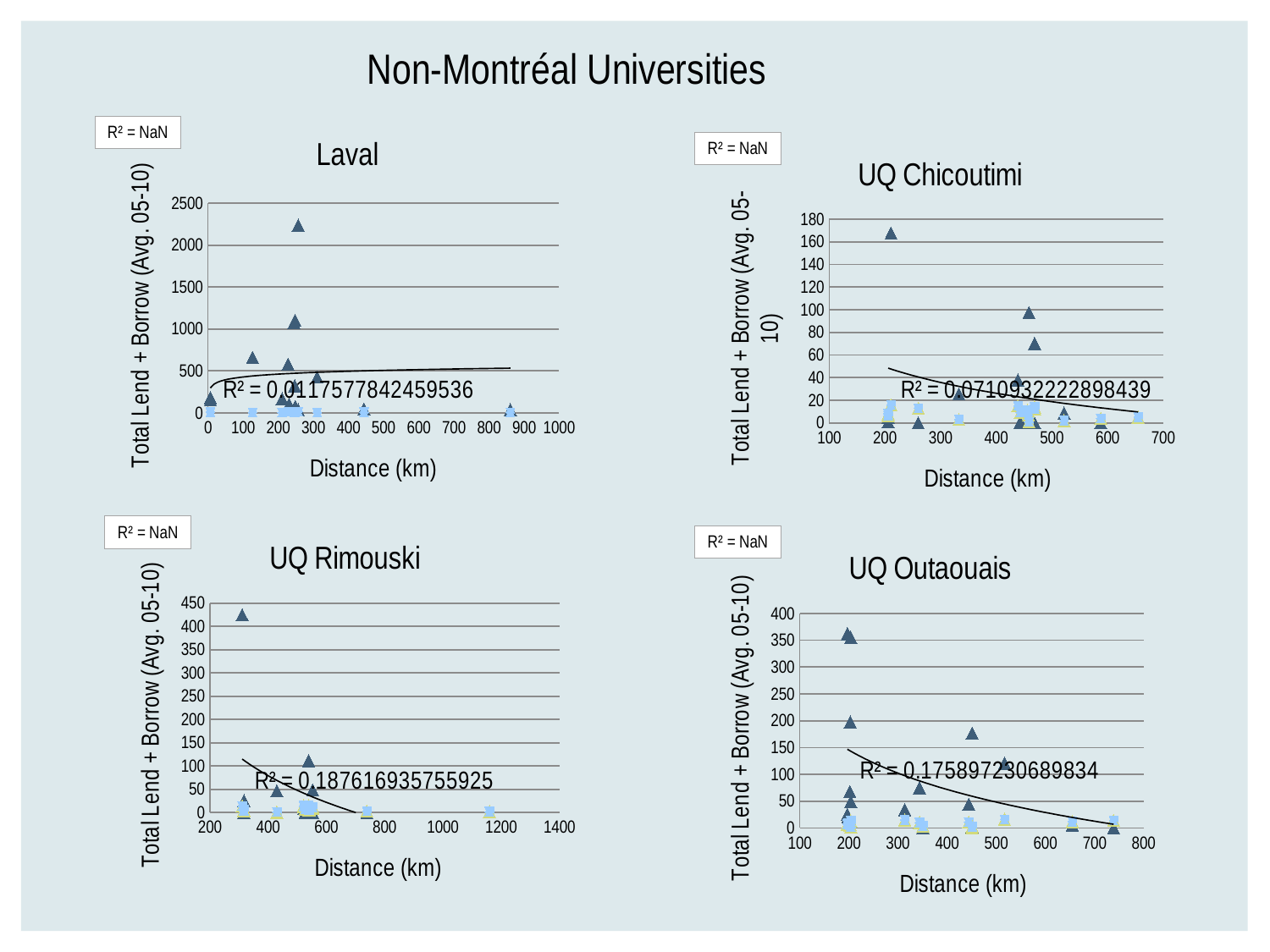
What is the x-axis label of the UQ Outaouais chart? Distance (km) In the Laval chart, does the fitted trend line rise or fall as distance increases? rise In the UQ Outaouais chart, is the highest plotted point greater or less than 300? greater What R² value is printed on the UQ Rimouski chart? R² = 0.187616935755925 In the Laval chart, is the highest plotted point greater or less than 2000? greater In the UQ Chicoutimi chart, does the fitted trend line rise or fall as distance increases? fall In the UQ Rimouski chart, is the highest plotted point located at a distance greater or less than 400 km? less In the UQ Outaouais chart, does the fitted trend line rise or fall as distance increases? fall How many charts are shown on the slide? 4 What kind of chart is the Laval chart? scatter chart